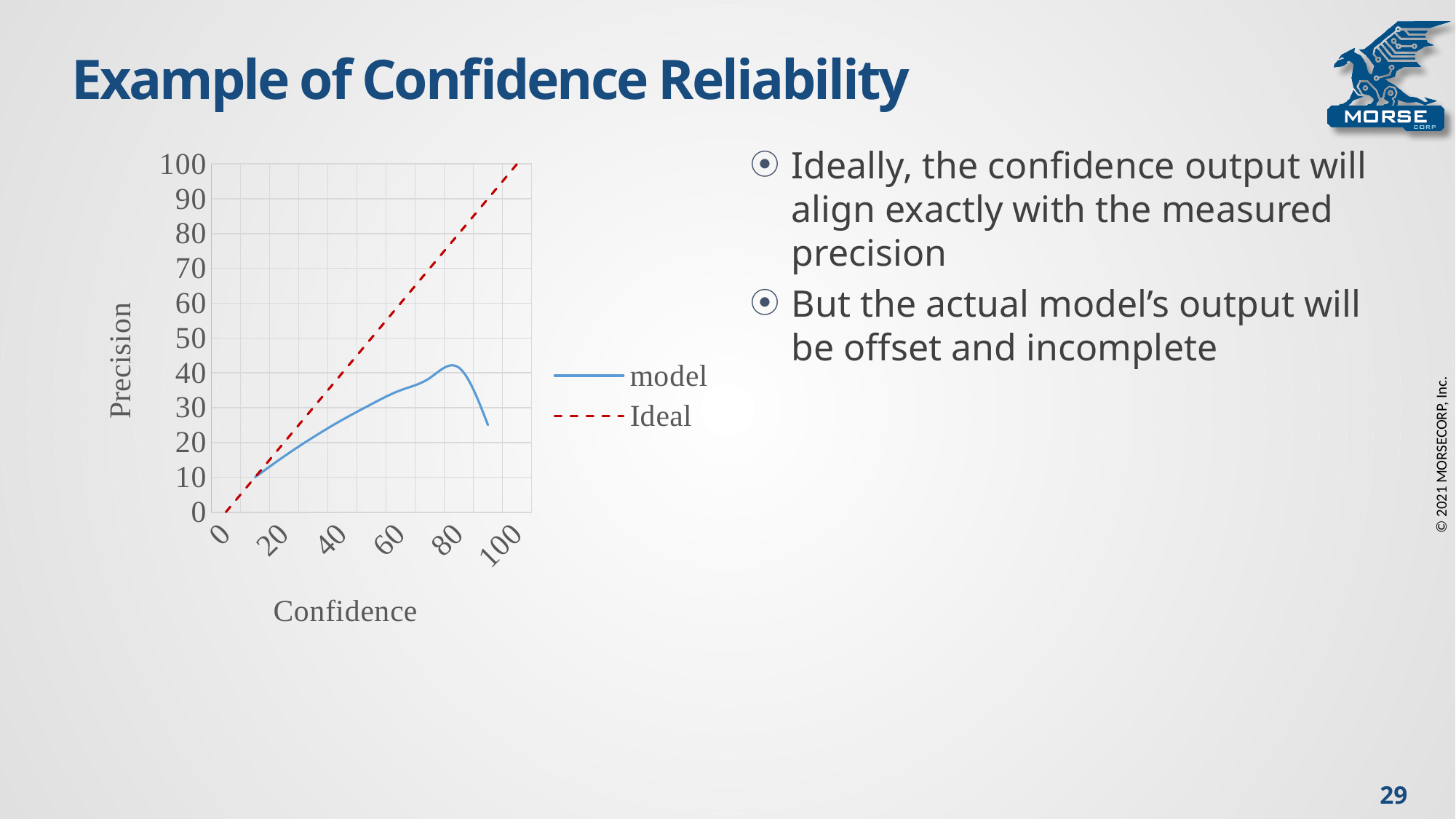
What is the Ideal precision value at a confidence of 100? 100 How many series does the chart legend list? 2 After reaching its peak near a confidence of 80, does the model line rise or fall? fall What is the label of the chart's vertical axis? Precision What are the two series named in the chart legend? model and Ideal What kind of chart is shown on the slide? line chart At a confidence of 60, which series has the higher precision, model or Ideal? Ideal Does the Ideal line rise or fall as confidence increases? rise Is the model's precision at a confidence of 40 greater or less than 20? greater Is the model's highest precision value greater or less than 50? less Is the model's precision at a confidence of 80 greater or less than 50? less What is the Ideal precision value at a confidence of 0? 0